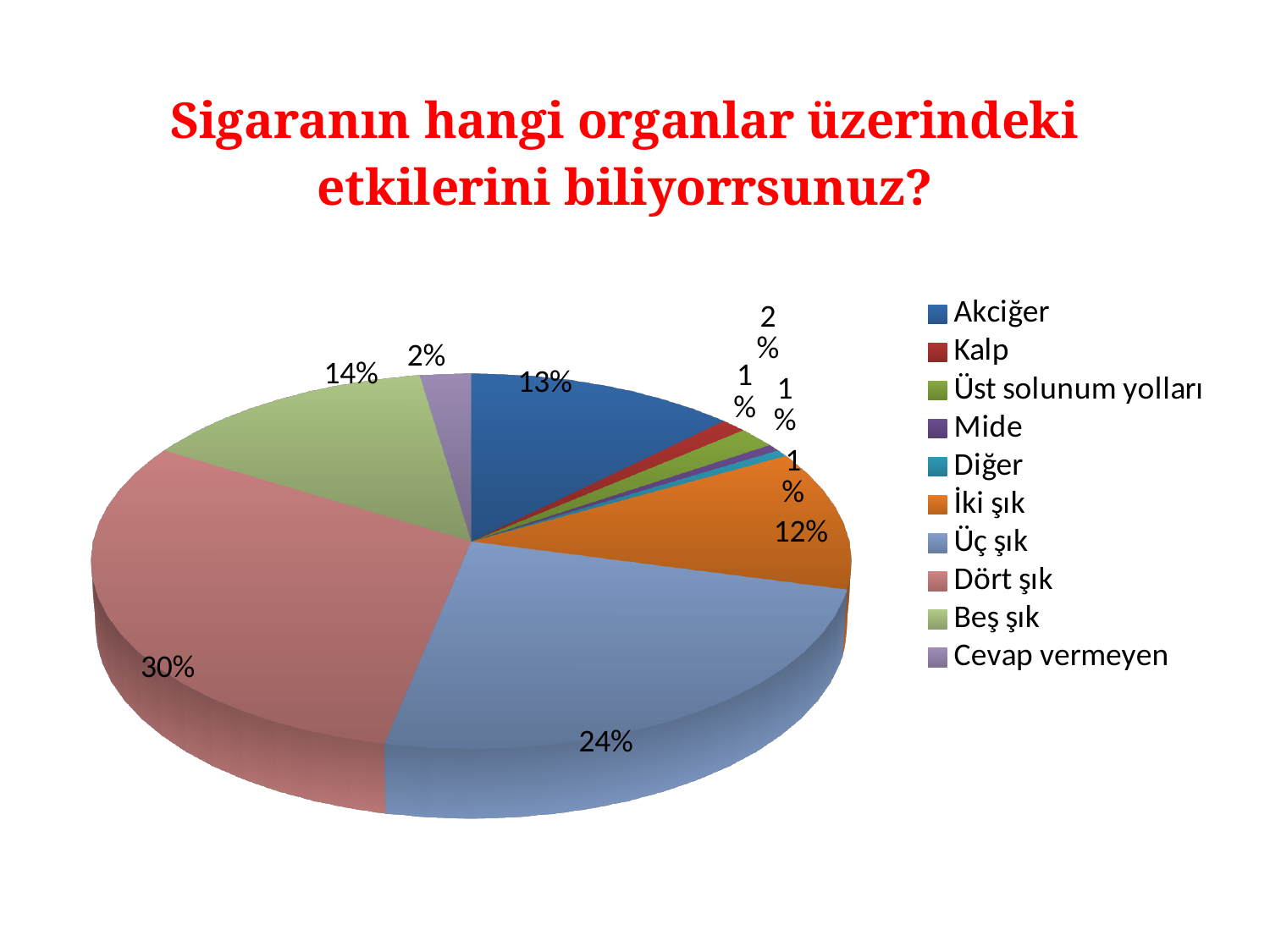
Which category has the largest slice of the pie? Dört şık Which is larger, the slice for Beş şık or the slice for Akciğer? Beş şık What is the title of the chart on the slide? Sigaranın hangi organlar üzerindeki etkilerini biliyorrsunuz? What percentage is shown for Üç şık? 24% How many categories does the legend list? 10 What percentage is shown for Akciğer? 13% What percentage is shown for Beş şık? 14% What percentage is shown for İki şık? 12% What is the combined share of Dört şık and Üç şık? 54% What percentage of the pie is labelled for Dört şık? 30% What type of chart is shown on the slide? Pie chart What is the difference in percentage points between Dört şık and Üç şık? 6